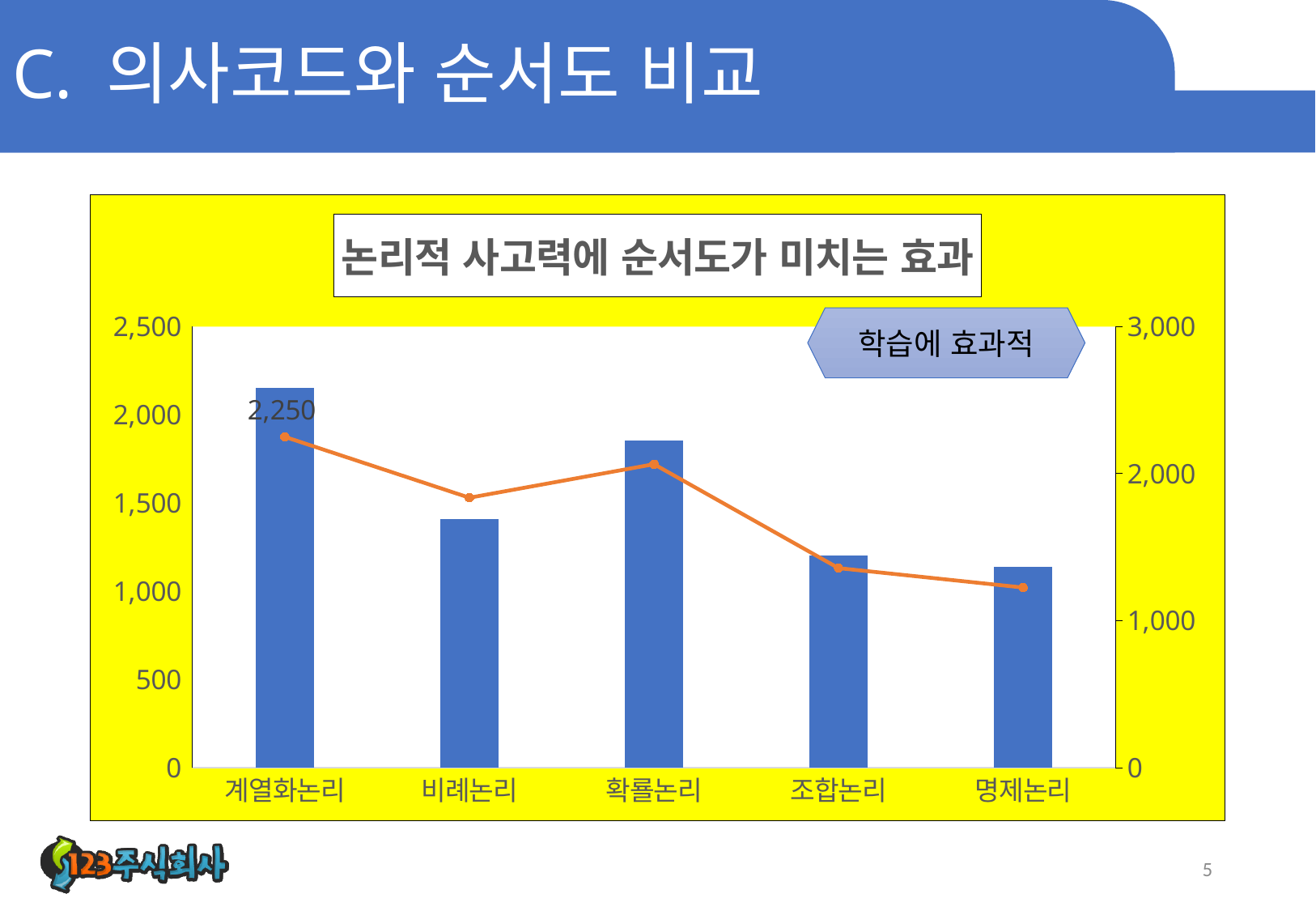
Which bar is taller, 비례논리 or 확률논리? 확률논리 What text is written in the callout shape inside the chart? 학습에 효과적 Does the orange line generally rise or fall from 계열화논리 to 명제논리? fall What kind of chart is shown on the slide? A bar chart combined with a line How many categories are shown on the x axis of the chart? 5 Is the bar value for 조합논리 on the left axis greater or less than 1,000? greater What is the only data label printed on the chart? 2,250 What is the title of the chart? 논리적 사고력에 순서도가 미치는 효과 Is the bar value for 계열화논리 on the left axis greater or less than 2,000? greater Is the bar value for 비례논리 on the left axis greater or less than 1,500? less Which category has the tallest bar in the chart? 계열화논리